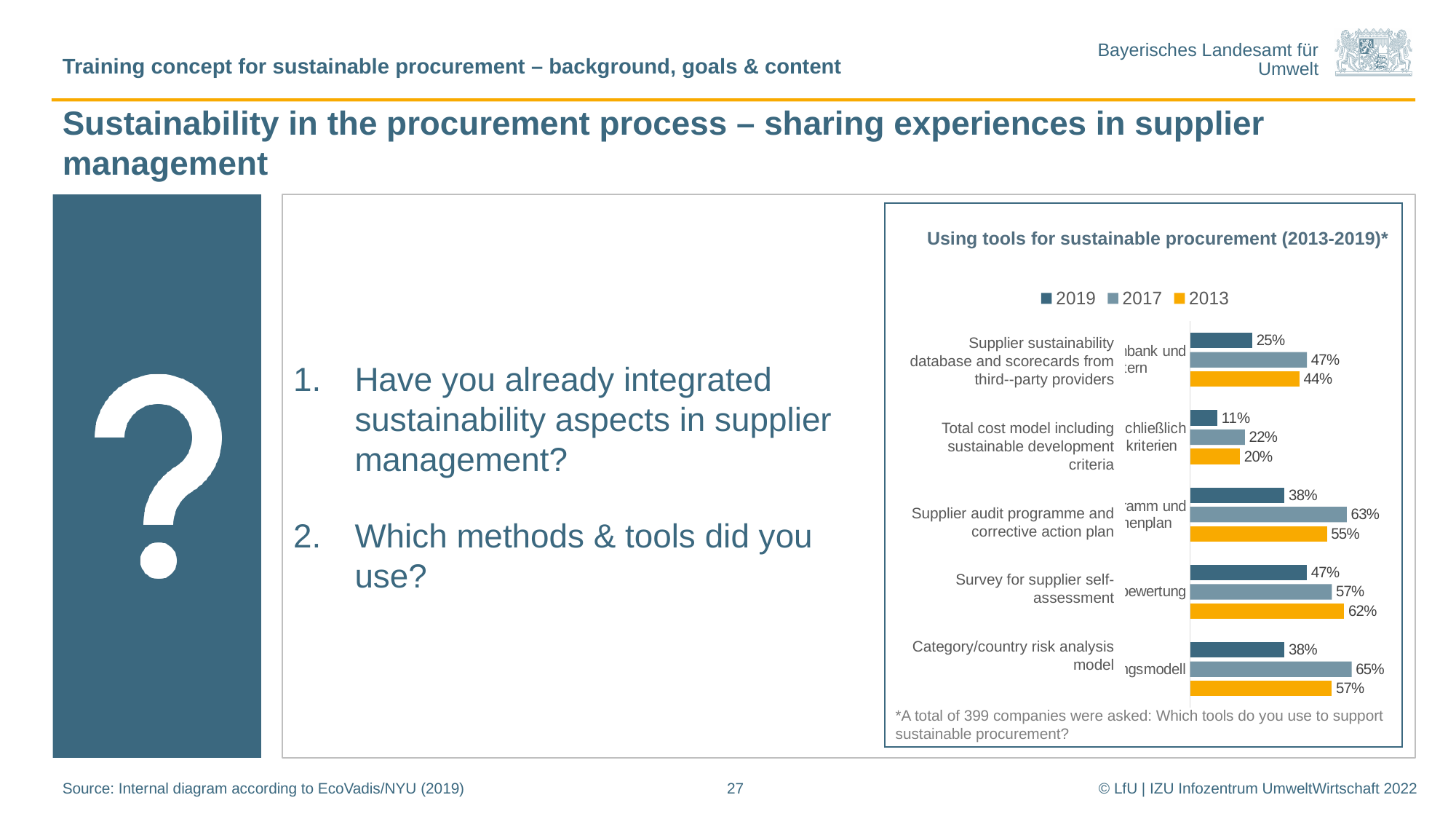
What is the title of the chart? Using tools for sustainable procurement (2013-2019)* How many series does the chart legend list? 3 What kind of chart is shown on the slide? Bar chart What is the difference between the 2017 and 2019 values for 'Supplier audit programme and corrective action plan'? 25% What is the 2013 value for 'Total cost model including sustainable development criteria'? 20% What is the 2019 value for 'Survey for supplier self-assessment'? 47% Which category has the lowest 2019 value? Total cost model including sustainable development criteria What is the 2017 value for 'Category/country risk analysis model'? 65% Which year has the highest value for 'Survey for supplier self-assessment'? 2013 How many tool categories are shown in the chart? 5 Which category has the highest 2017 value? Category/country risk analysis model For 'Supplier sustainability database and scorecards from third-party providers', which is larger: the 2017 value or the 2013 value? 2017